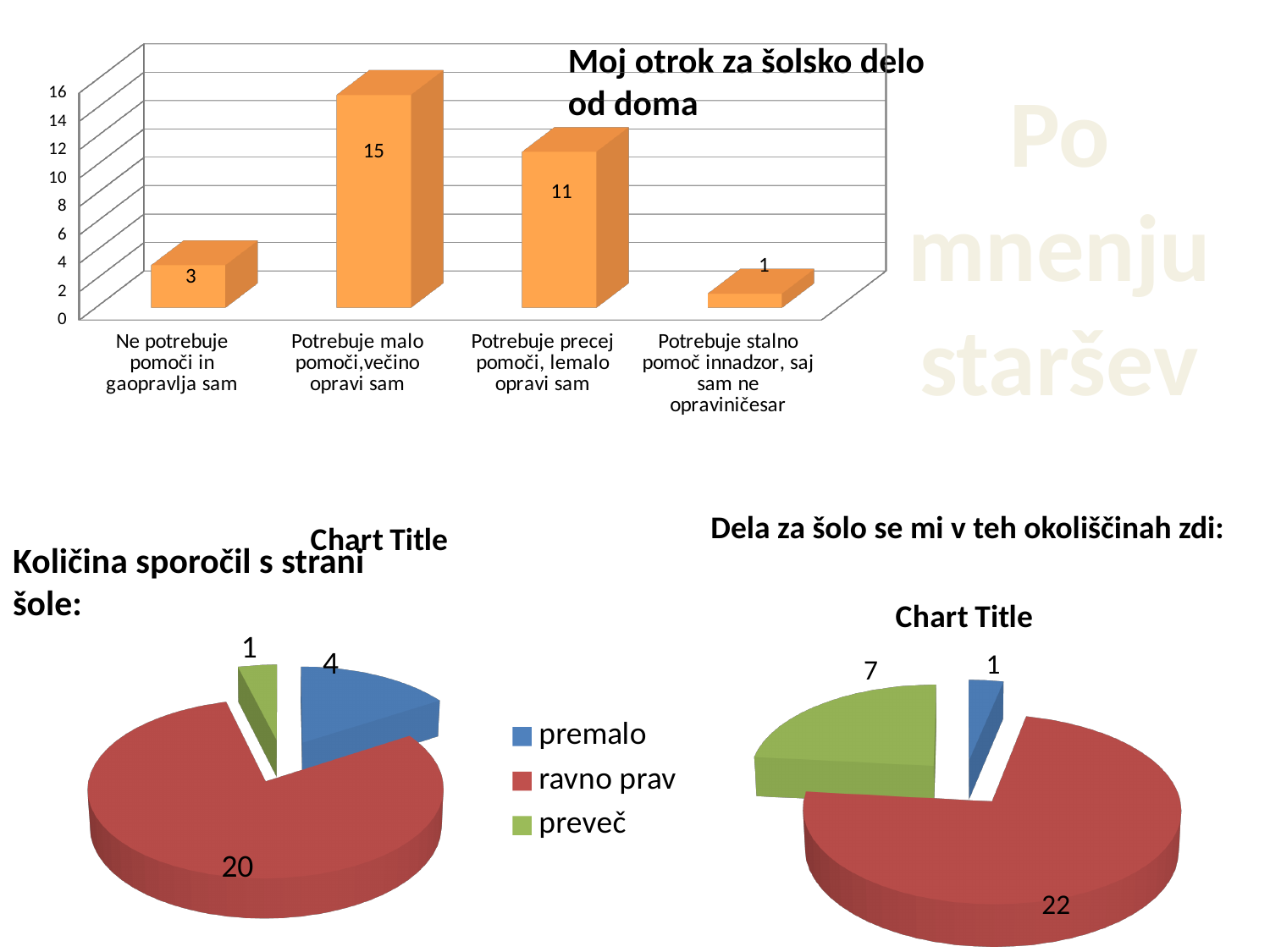
In the pie chart under 'Količina sporočil s strani šole:', what is the value for 'ravno prav'? 20 In the pie chart under 'Dela za šolo se mi v teh okoliščinah zdi:', what is the value of the green slice? 7 In the bar chart 'Moj otrok za šolsko delo od doma', which category has the lowest value? Potrebuje stalno pomoč innadzor, saj sam ne opraviničesar In the bar chart 'Moj otrok za šolsko delo od doma', what is the difference between the values for 'Potrebuje malo pomoči,večino opravi sam' and 'Ne potrebuje pomoči in gaopravlja sam'? 12 How many categories are shown in the bar chart 'Moj otrok za šolsko delo od doma'? 4 In the bar chart 'Moj otrok za šolsko delo od doma', what is the value for 'Potrebuje precej pomoči, lemalo opravi sam'? 11 What kind of chart is the chart titled 'Moj otrok za šolsko delo od doma'? bar chart In the pie chart under 'Količina sporočil s strani šole:', what share of the total does 'ravno prav' represent? 80% In the bar chart 'Moj otrok za šolsko delo od doma', what is the value for 'Potrebuje malo pomoči,večino opravi sam'? 15 In the bar chart 'Moj otrok za šolsko delo od doma', which category has the highest value? Potrebuje malo pomoči,večino opravi sam In the pie chart under 'Količina sporočil s strani šole:', which is larger, 'premalo' or 'preveč'? premalo How many entries does the legend between the two pie charts list? 3